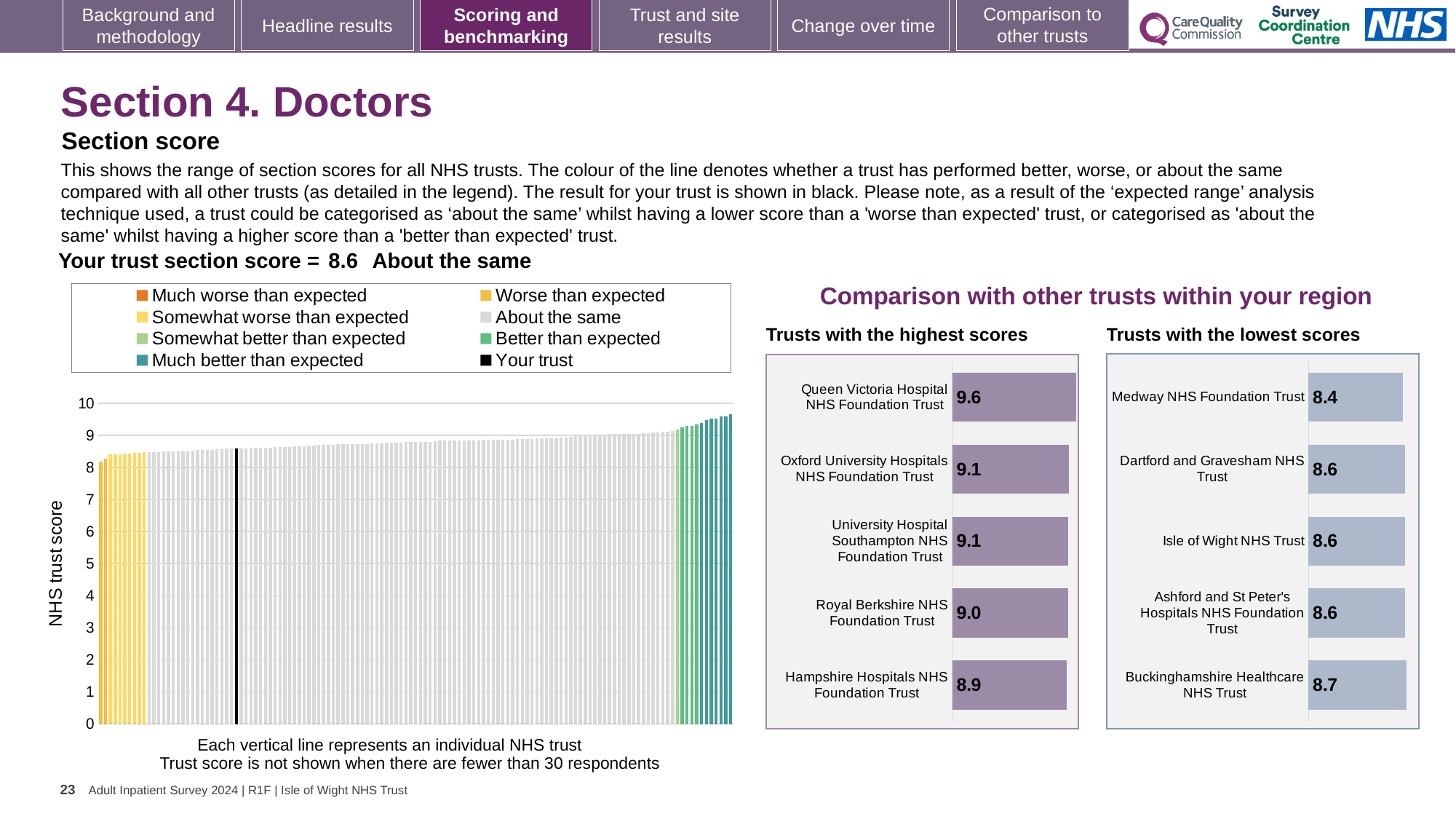
In the 'Trusts with the lowest scores' chart, what is the score for Medway NHS Foundation Trust? 8.4 In the 'Trusts with the highest scores' chart, what is the score for Hampshire Hospitals NHS Foundation Trust? 8.9 In the 'Trusts with the lowest scores' chart, which is larger: the score for Buckinghamshire Healthcare NHS Trust or the score for Medway NHS Foundation Trust? Buckinghamshire Healthcare NHS Trust In the 'Trusts with the highest scores' chart, which trust has the highest score? Queen Victoria Hospital NHS Foundation Trust In the 'Trusts with the lowest scores' chart, which trust has the lowest score? Medway NHS Foundation Trust In the 'Trusts with the highest scores' chart, what is the score for Queen Victoria Hospital NHS Foundation Trust? 9.6 In the NHS trust score chart on the left, do the values rise or fall from left to right along the x axis? Rise In the 'Trusts with the highest scores' chart, how many trusts are shown? 5 In the NHS trust score chart on the left, how many entries does the legend list? 8 In the 'Trusts with the highest scores' chart, what is the difference between the scores of Queen Victoria Hospital NHS Foundation Trust and Hampshire Hospitals NHS Foundation Trust? 0.7 In the 'Trusts with the lowest scores' chart, what is the difference between the scores of Buckinghamshire Healthcare NHS Trust and Medway NHS Foundation Trust? 0.3 What kind of chart is the NHS trust score chart on the left of the slide? Bar chart